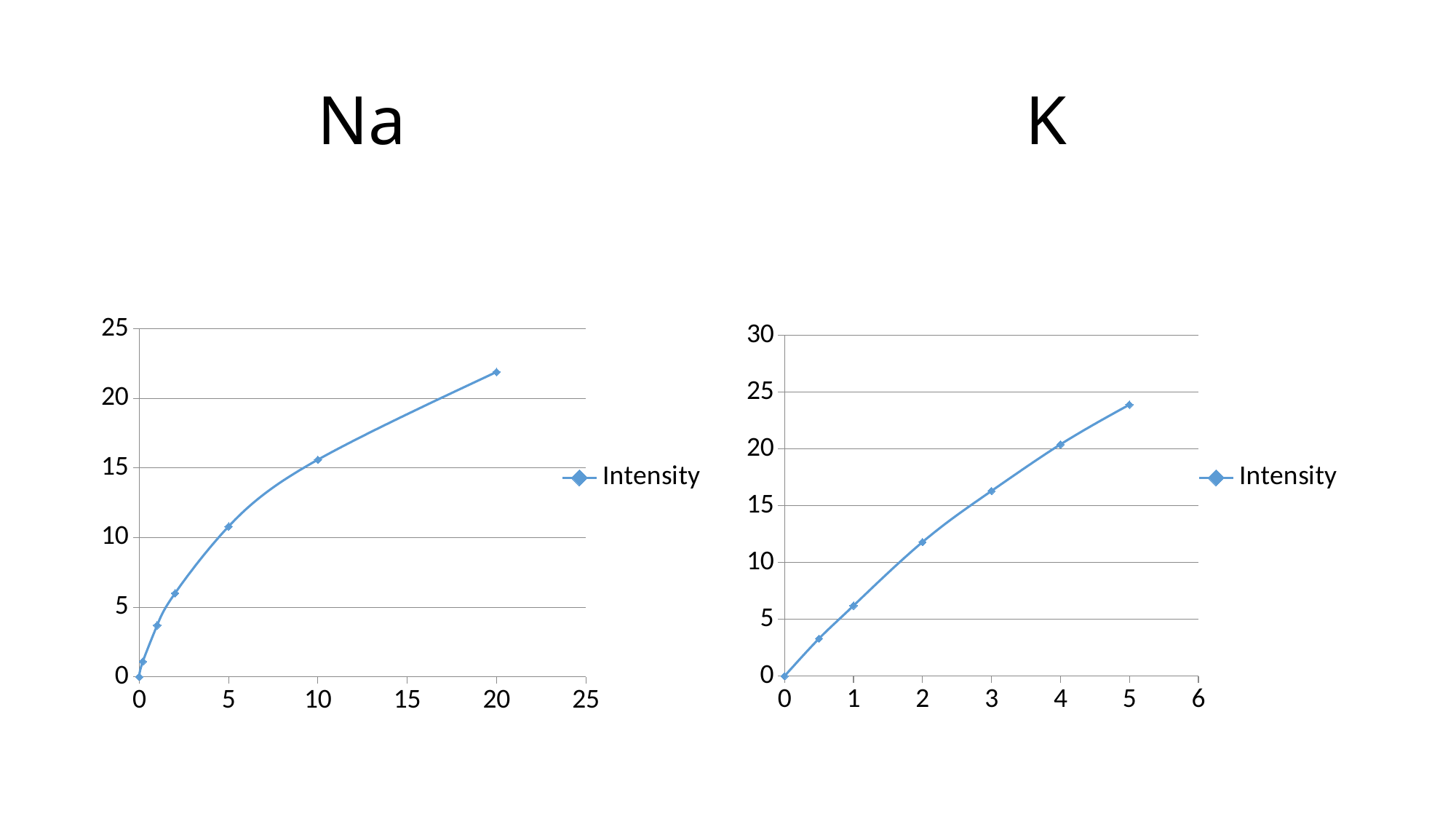
In the K chart, is the Intensity value at x = 2 greater or less than 10? greater How many data points are plotted in the K chart? 7 How many series does the legend of the K chart list? 1 In the Na chart, do the Intensity values rise or fall as x increases? rise In the K chart, is the Intensity value at x = 5 greater or less than 25? less What is the name of the series shown in the Na chart's legend? Intensity In the Na chart, is the Intensity value at x = 20 greater or less than 20? greater What is the highest tick shown on the y axis of the K chart? 30 In the K chart, do the Intensity values rise or fall as x increases? rise What kind of chart is the Na chart? line chart In the K chart, which x value has the highest Intensity? 5